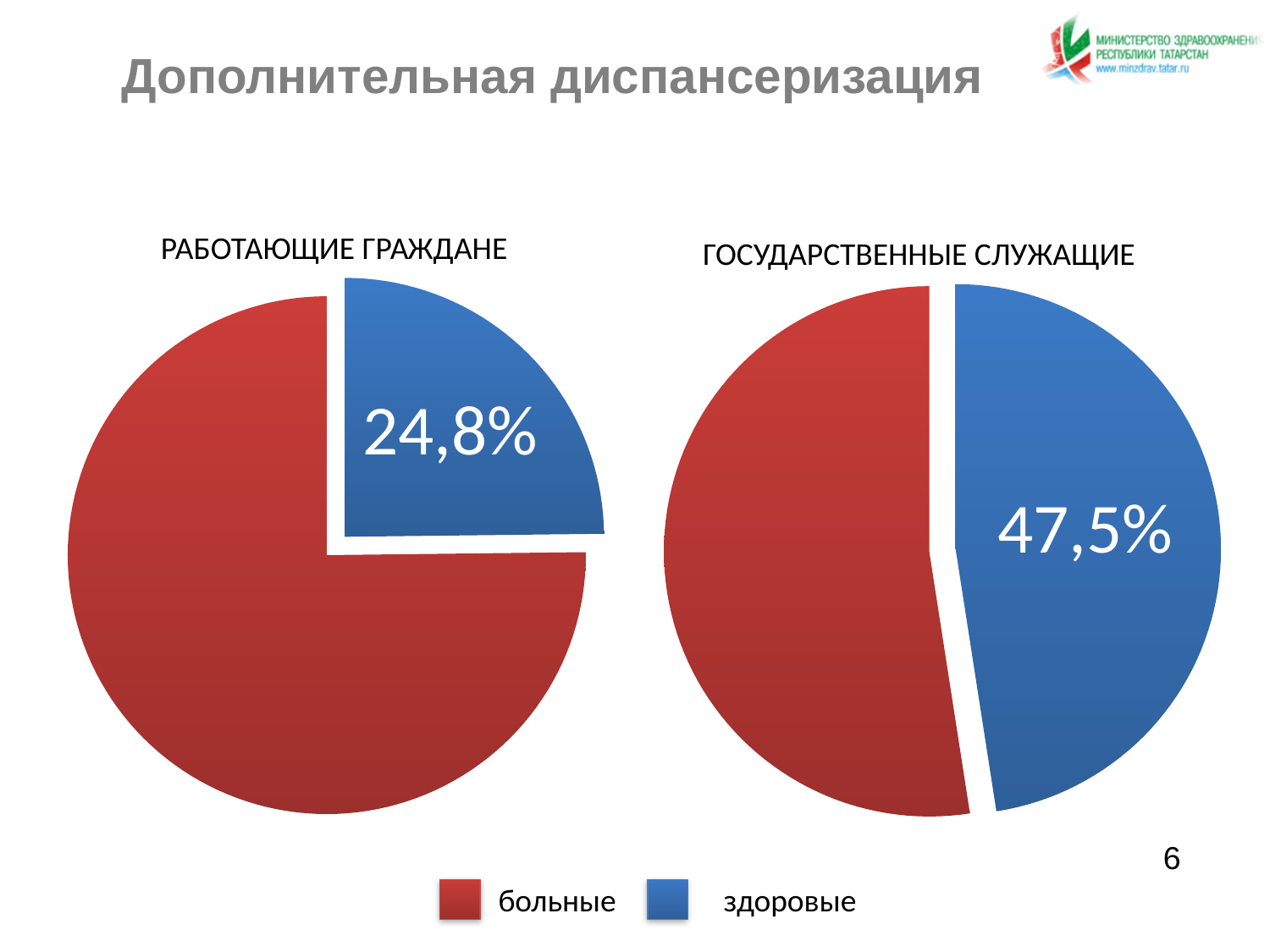
What kind of chart is used for РАБОТАЮЩИЕ ГРАЖДАНЕ? Pie chart In the ГОСУДАРСТВЕННЫЕ СЛУЖАЩИЕ pie chart, which slice is the smallest? здоровые In the ГОСУДАРСТВЕННЫЕ СЛУЖАЩИЕ pie chart, what share is labelled for the здоровые slice? 47,5% Is the здоровые share in the РАБОТАЮЩИЕ ГРАЖДАНЕ pie chart greater or less than 50%? less How many pie charts are shown on the slide? 2 In the РАБОТАЮЩИЕ ГРАЖДАНЕ pie chart, which slice is the largest? больные How many slices does the ГОСУДАРСТВЕННЫЕ СЛУЖАЩИЕ pie chart have? 2 Which chart shows a larger share of здоровые: РАБОТАЮЩИЕ ГРАЖДАНЕ or ГОСУДАРСТВЕННЫЕ СЛУЖАЩИЕ? ГОСУДАРСТВЕННЫЕ СЛУЖАЩИЕ According to the legend, which colour represents больные? Red By how many percentage points does the здоровые share in ГОСУДАРСТВЕННЫЕ СЛУЖАЩИЕ exceed that in РАБОТАЮЩИЕ ГРАЖДАНЕ? 22,7 In the РАБОТАЮЩИЕ ГРАЖДАНЕ pie chart, what share is labelled for the здоровые slice? 24,8% How many entries does the shared legend at the bottom of the slide list? 2